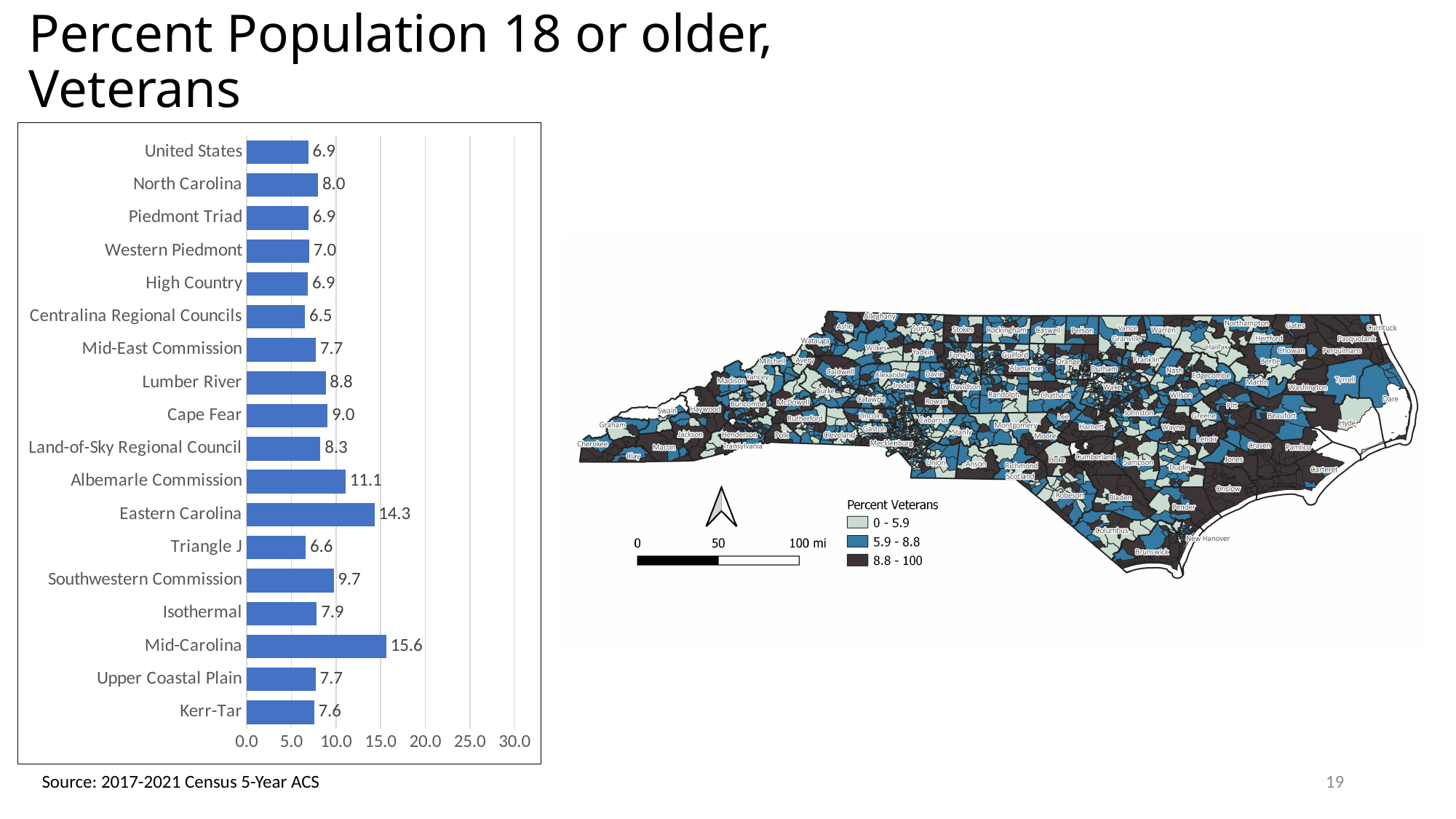
What is the difference between the values for North Carolina and United States in the bar chart? 1.1 What is the difference between the values for Mid-Carolina and Eastern Carolina in the bar chart? 1.3 How many categories are shown in the bar chart? 18 What kind of chart is shown on the left of the slide? bar chart How many classes does the map legend 'Percent Veterans' list? 3 In the bar chart, is the value for Eastern Carolina greater or less than 10.0? greater What is the value for Mid-Carolina in the bar chart? 15.6 Which category has the lowest value in the bar chart? Centralina Regional Councils In the bar chart, which is larger: Southwestern Commission or Cape Fear? Southwestern Commission Which category has the highest value in the bar chart? Mid-Carolina What is the value for Albemarle Commission in the bar chart? 11.1 What is the value for North Carolina in the bar chart? 8.0